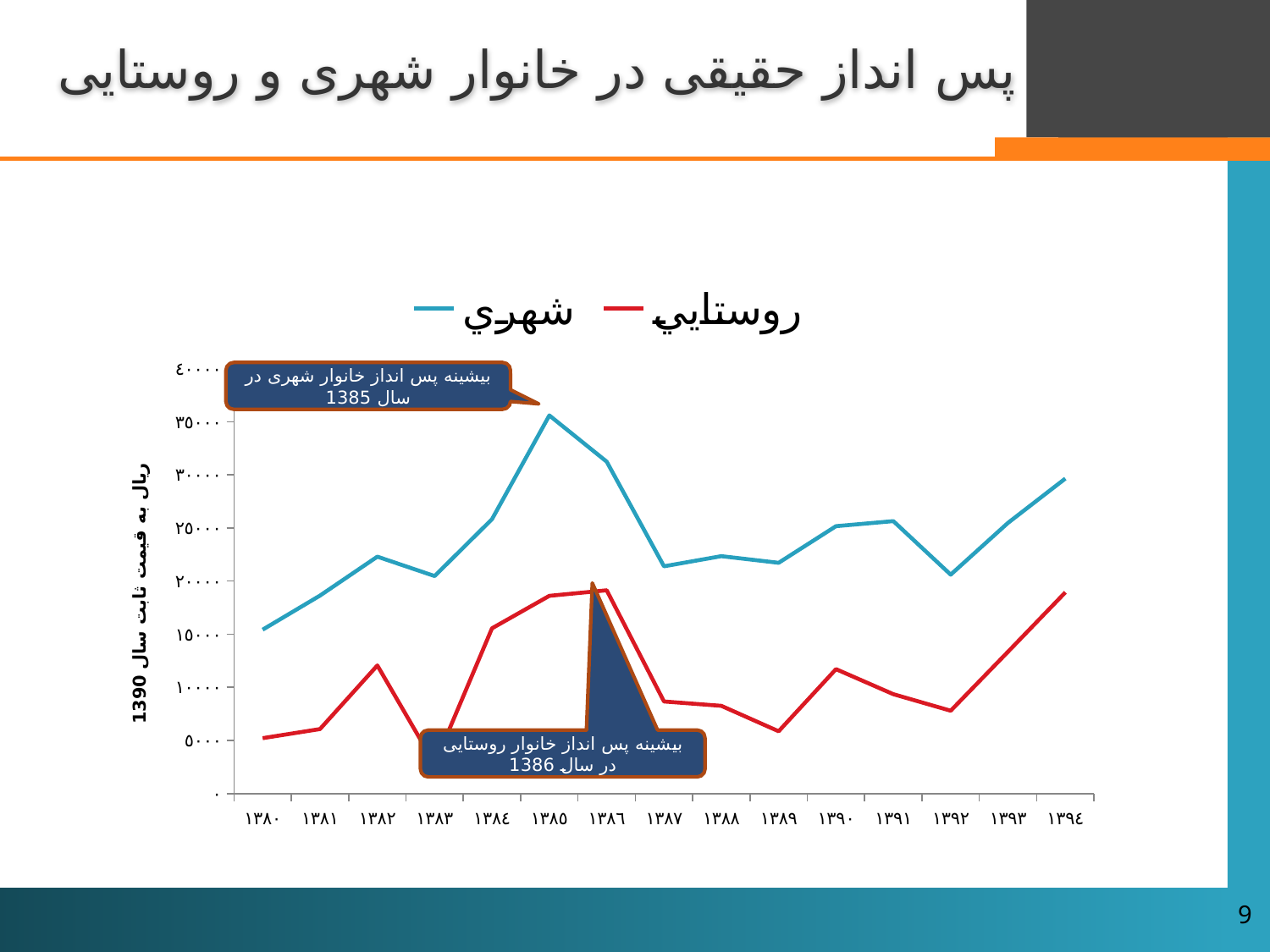
Does the روستايي (rural) series rise or fall from 1392 to 1394? rise What is the y-axis label of the chart? ریال به قیمت ثابت سال 1390 In which year does the شهري (urban) series reach its highest value? 1385 In which year is the شهري (urban) series at its lowest value? 1380 How many years are plotted along the x axis? 15 Is the value for شهري (urban) in 1385 greater or less than 30000? greater What kind of chart is shown on the slide? line chart In which year does the روستايي (rural) series reach its highest value? 1386 How many series does the legend list? 2 Which series has the larger value in 1385, شهري (urban) or روستايي (rural)? شهري (urban) Is the value for روستايي (rural) in 1386 greater or less than 20000? less